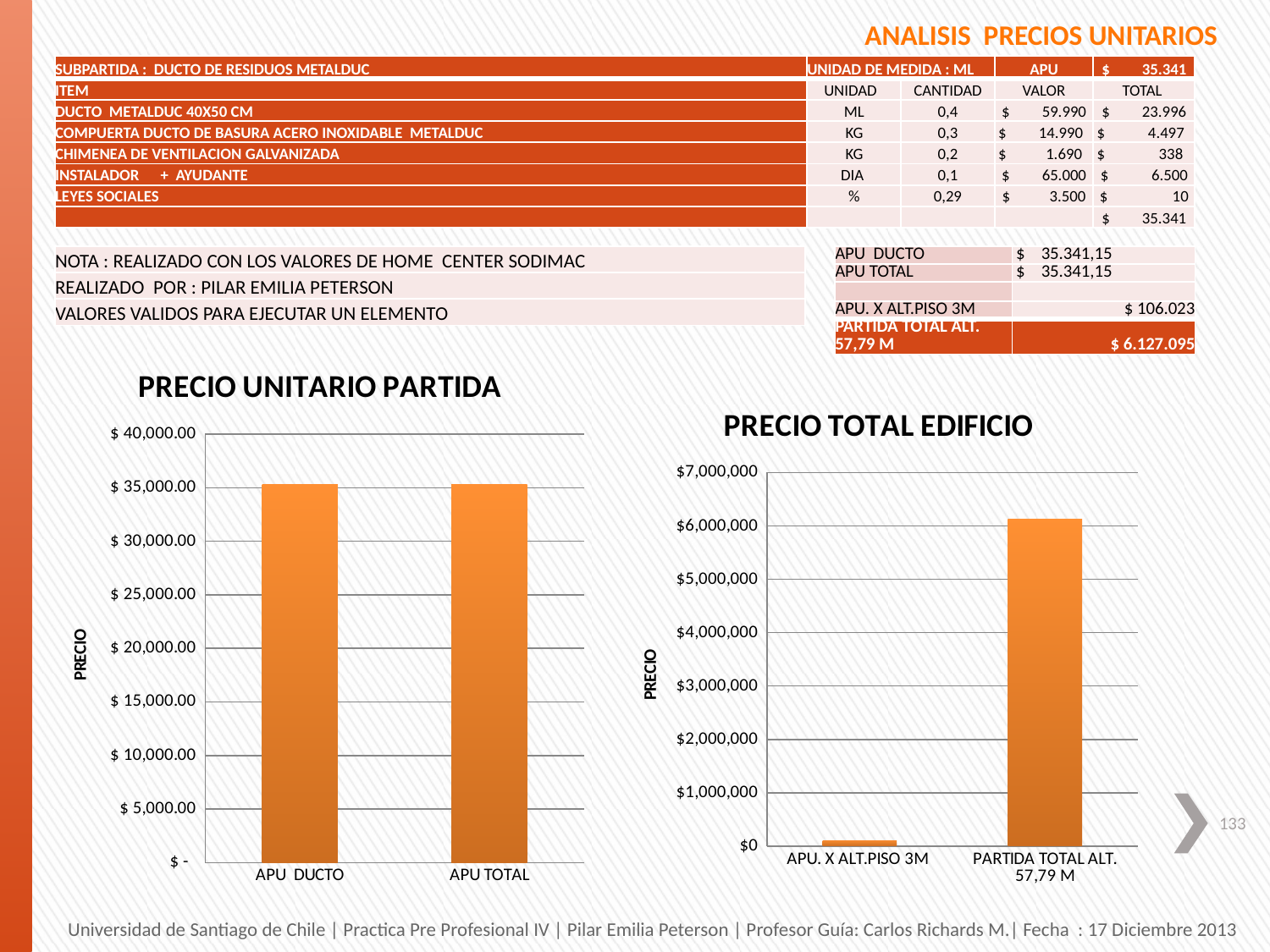
How many categories are shown in the "PRECIO UNITARIO PARTIDA" chart? 2 In the "PRECIO TOTAL EDIFICIO" chart, which is larger: APU. X ALT.PISO 3M or PARTIDA TOTAL ALT. 57,79 M? PARTIDA TOTAL ALT. 57,79 M What is the y-axis title of the "PRECIO UNITARIO PARTIDA" chart? PRECIO What kind of chart is the "PRECIO UNITARIO PARTIDA" chart? bar chart In the "PRECIO TOTAL EDIFICIO" chart, is the value for APU. X ALT.PISO 3M greater or less than $1,000,000? less In the "PRECIO TOTAL EDIFICIO" chart, is the value for PARTIDA TOTAL ALT. 57,79 M greater or less than $5,000,000? greater In the "PRECIO TOTAL EDIFICIO" chart, which category has the highest value? PARTIDA TOTAL ALT. 57,79 M In the "PRECIO TOTAL EDIFICIO" chart, which category has the lowest value? APU. X ALT.PISO 3M In the "PRECIO UNITARIO PARTIDA" chart, is the value for APU DUCTO greater or less than $30,000.00? greater What kind of chart is the "PRECIO TOTAL EDIFICIO" chart? bar chart How many categories are shown in the "PRECIO TOTAL EDIFICIO" chart? 2